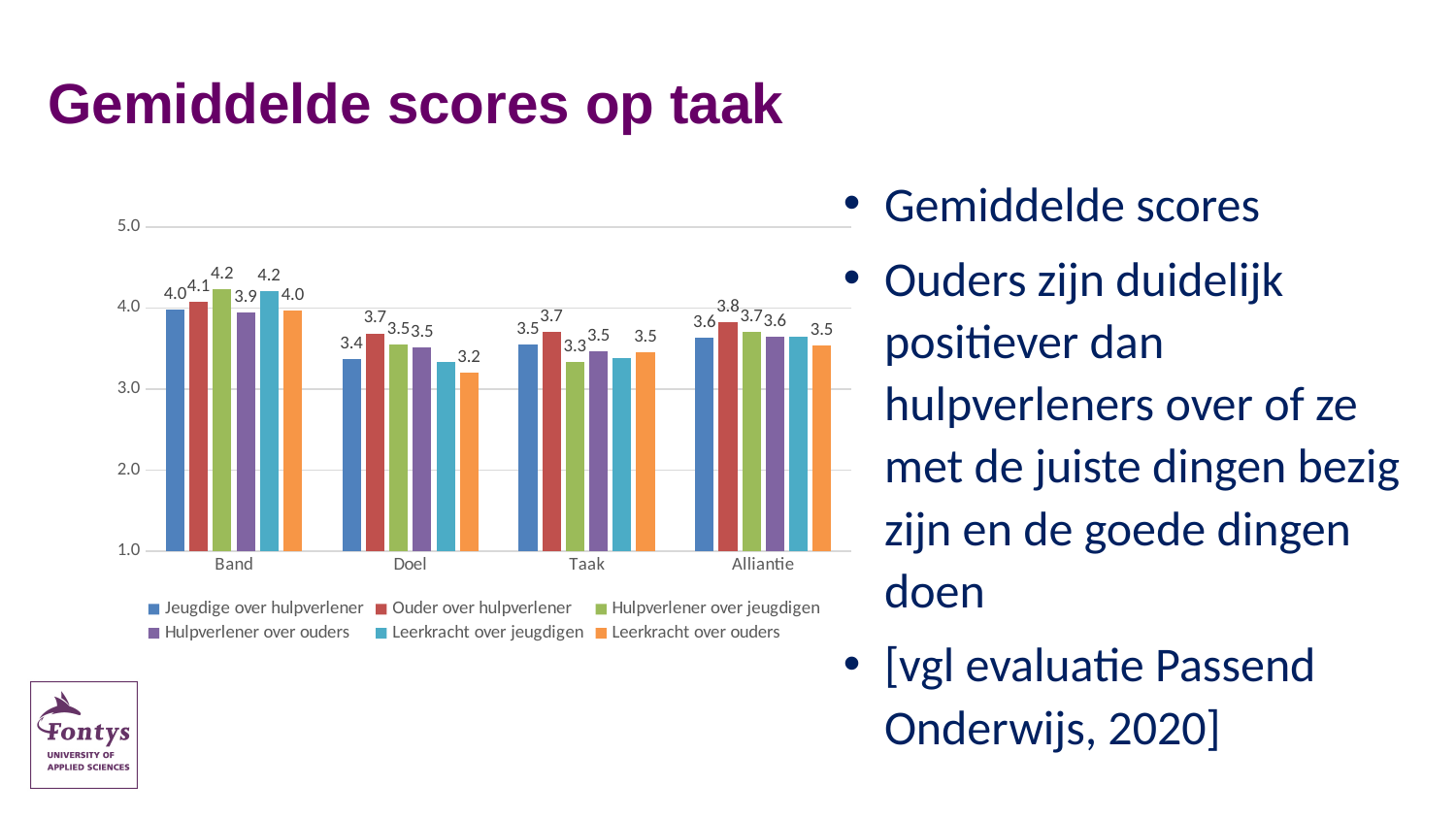
How many categories are shown on the x axis? 4 In the Doel category, which is larger: Ouder over hulpverlener or Jeugdige over hulpverlener? Ouder over hulpverlener What is the difference between the Ouder over hulpverlener values for Band and Doel? 0.4 What kind of chart is shown on the slide? bar chart What is the value for Ouder over hulpverlener in the Doel category? 3.7 Is the value for Hulpverlener over jeugdigen in the Band category greater or less than 4.0? greater What is the value for Leerkracht over ouders in the Doel category? 3.2 Which series has the highest value in the Alliantie category? Ouder over hulpverlener How many series does the legend list? 6 What is the value for Ouder over hulpverlener in the Alliantie category? 3.8 In which category does Leerkracht over ouders have its lowest value? Doel In which category does Ouder over hulpverlener have its highest value? Band